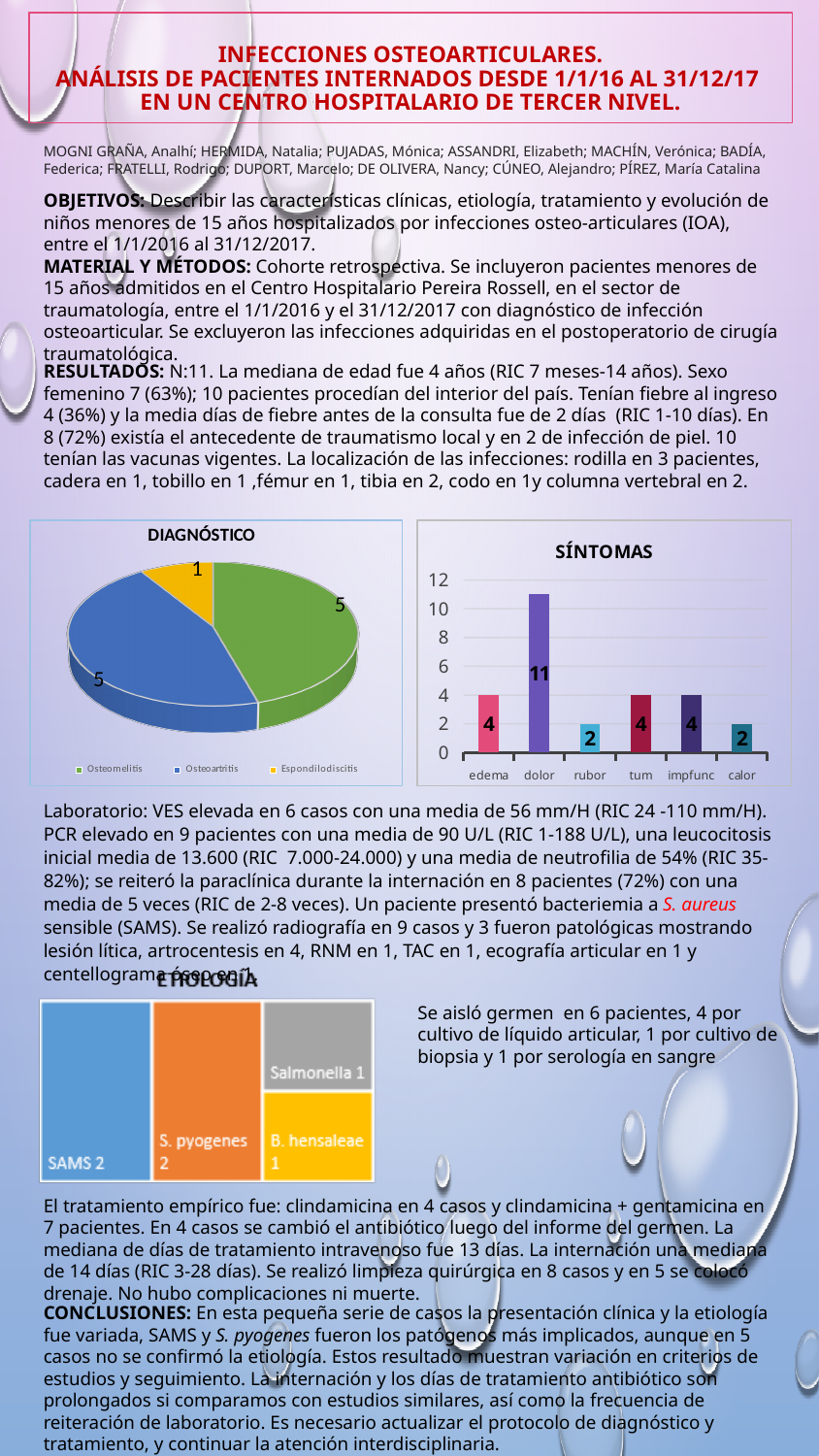
In the DIAGNÓSTICO chart, what is the value for Espondilodiscitis? 1 In the ETIOLOGÍA chart, what is the value for S. pyogenes? 2 In the DIAGNÓSTICO chart, which diagnosis has the lowest value? Espondilodiscitis In the ETIOLOGÍA chart, what is the value for Salmonella? 1 In the SÍNTOMAS chart, what is the value for dolor? 11 In the SÍNTOMAS chart, what is the difference between the values for dolor and edema? 7 What kind of chart is the SÍNTOMAS chart? bar chart In the SÍNTOMAS chart, how many symptom categories are shown? 6 In the SÍNTOMAS chart, which is larger, the value for tum or the value for calor? tum In the SÍNTOMAS chart, what is the value for rubor? 2 What kind of chart is the DIAGNÓSTICO chart? pie chart In the SÍNTOMAS chart, which symptom has the highest value? dolor